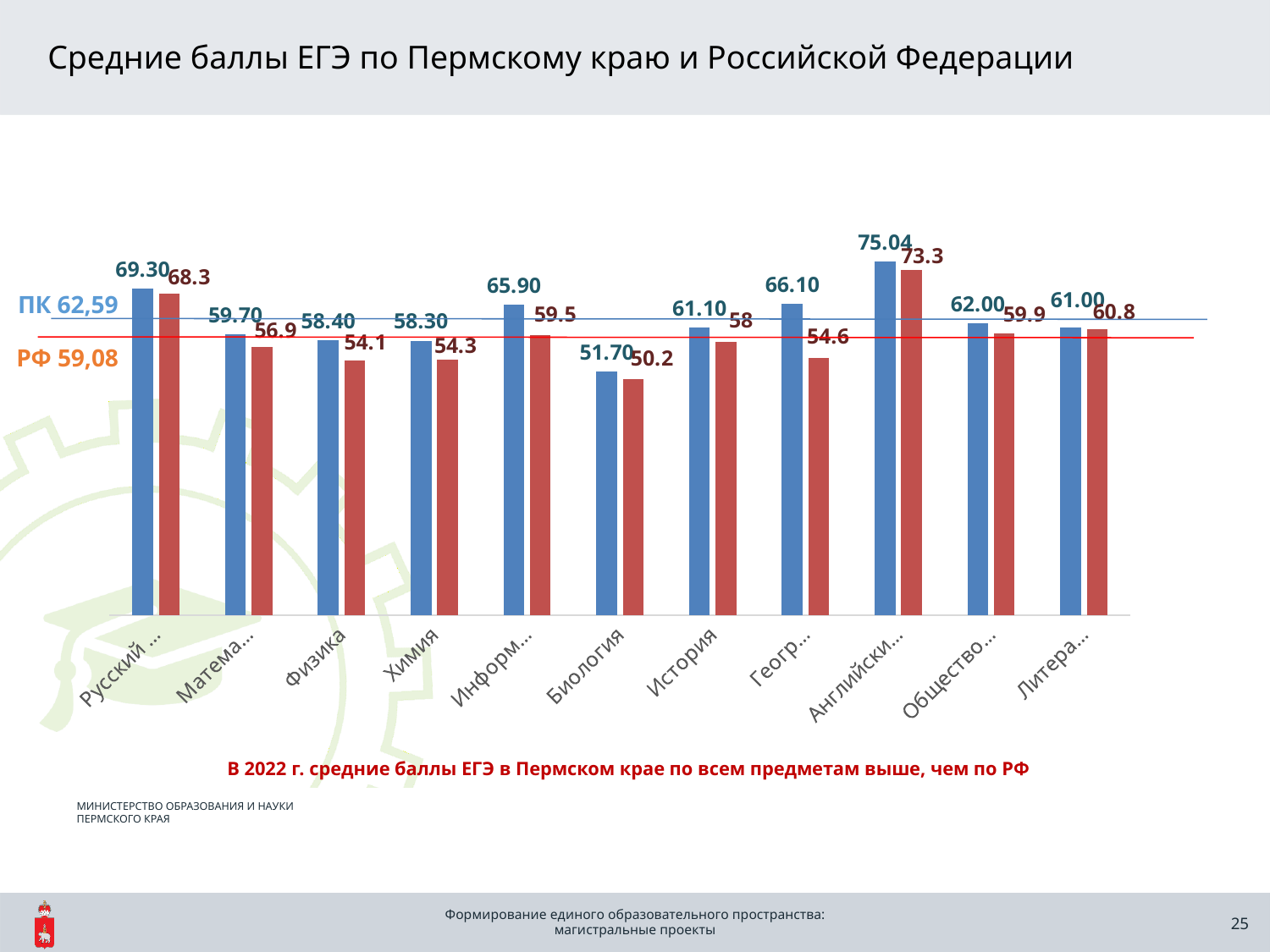
What is the value of the blue bar for Биология? 51.70 What is the difference between the blue bar and the red bar for Биология? 1.5 What type of chart is shown on the slide? bar chart What is the value of the blue bar for Физика? 58.40 What is the value of the red bar for Химия? 54.3 How many subject categories are shown on the x axis of the chart? 11 Which subject has the lowest blue bar? Биология What value is shown for the horizontal line labelled РФ? 59,08 What is the value of the red bar for История? 58 Which is larger for История: the blue bar or the red bar? the blue bar What value is shown for the horizontal line labelled ПК? 62,59 What is the difference between the blue bar and the red bar for Физика? 4.3